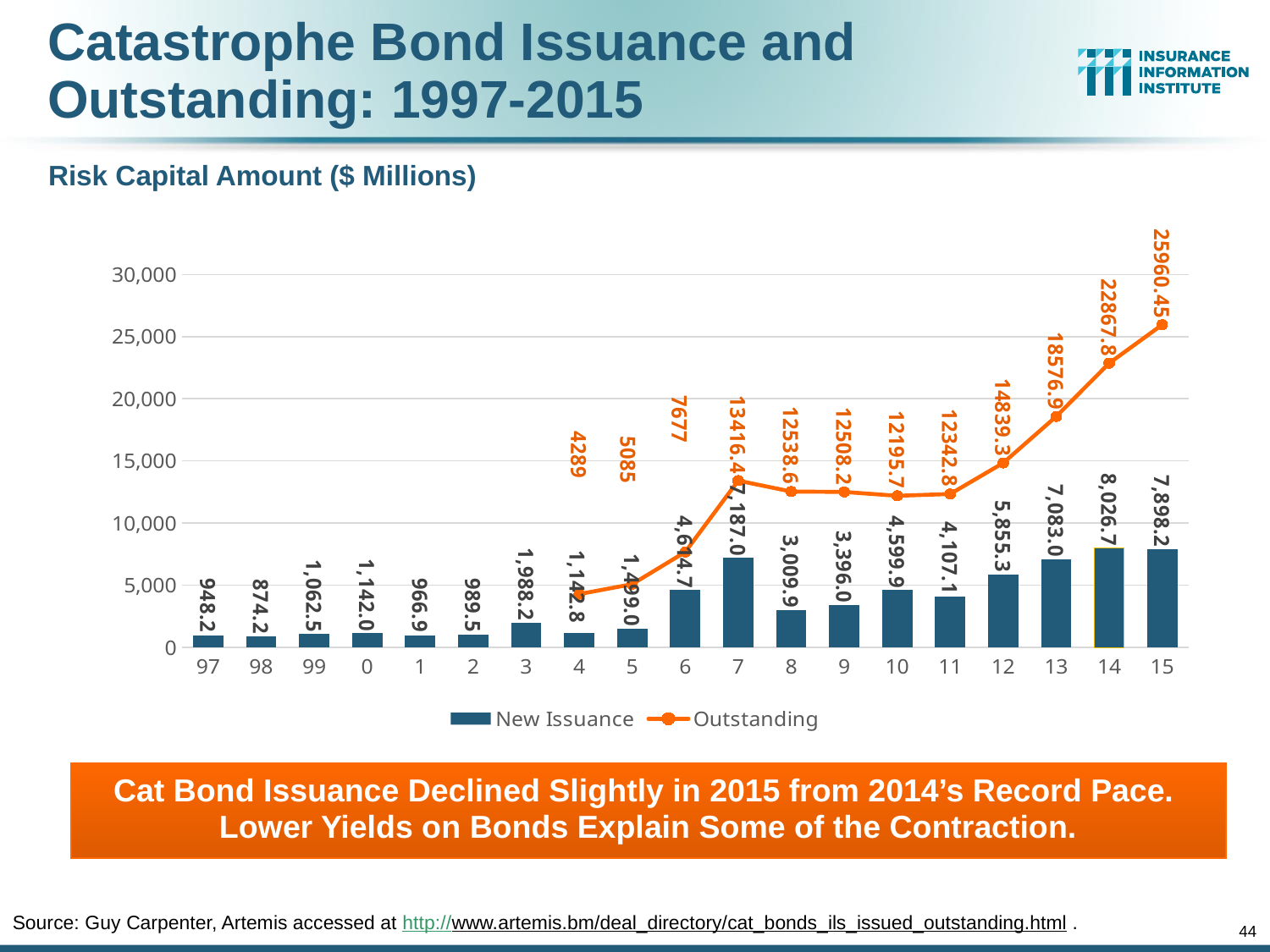
Which is larger, the New Issuance value for 7 or for 13? 7 Does the Outstanding line rise or fall from 11 to 15? rise What is the Outstanding value for 15? 25960.45 What is the difference between the New Issuance values for 14 and 15? 128.5 Which year has the lowest New Issuance value? 98 What is the Outstanding value for 7? 13416.4 What is the difference between the Outstanding values for 15 and 14? 3092.65 What is the New Issuance value for 14? 8,026.7 Which year has the highest New Issuance value? 14 How many years are shown on the x axis? 19 Is the Outstanding value for 12 greater or less than 15,000? less How many series does the legend list? 2